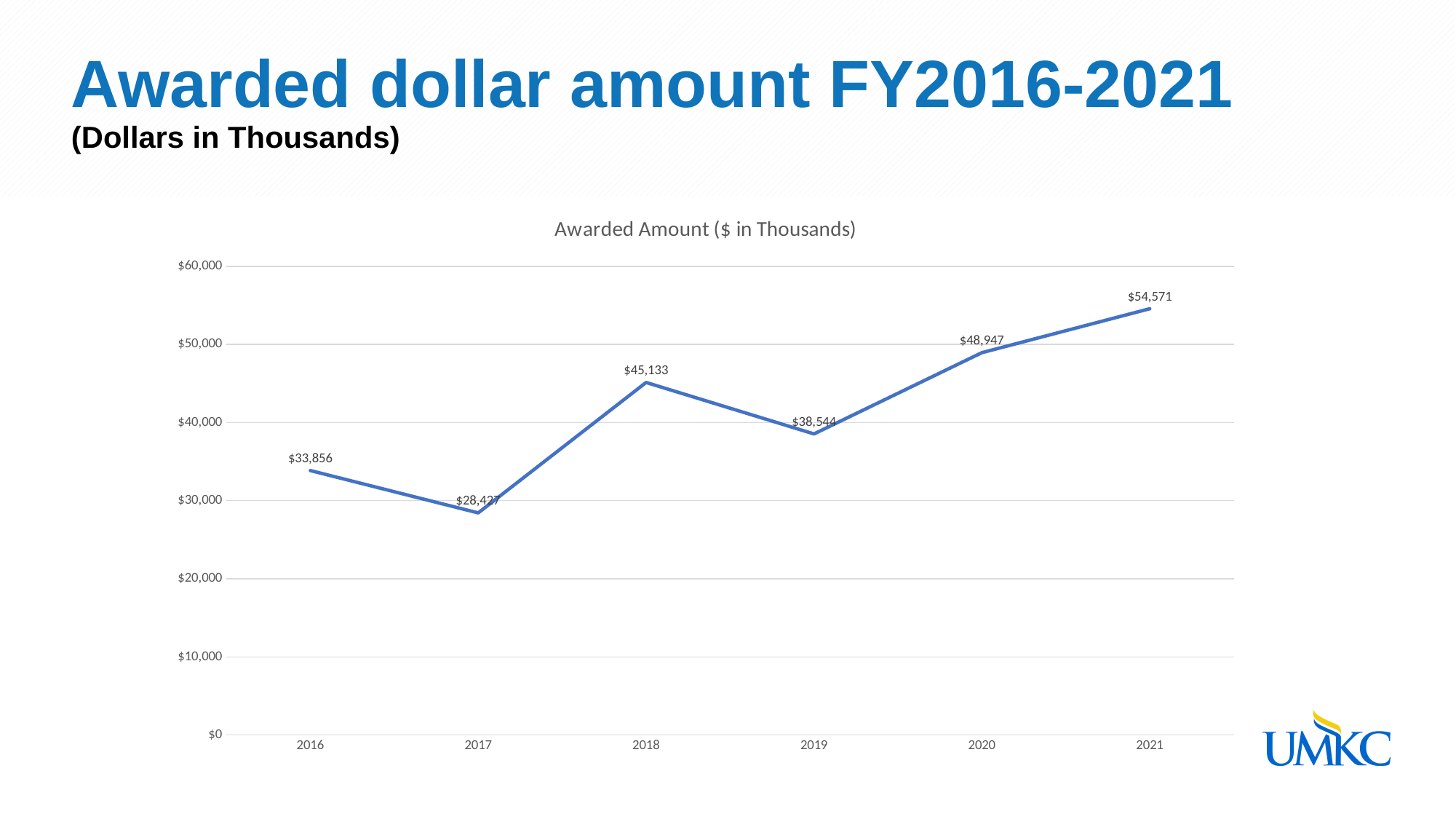
How many years are plotted on the chart? 6 What is the difference between the awarded amounts for 2021 and 2020? $5,624 What type of chart is shown on the slide? line chart What is the awarded amount for 2020? $48,947 Is the awarded amount for 2017 greater or less than $30,000? less What is the awarded amount for 2018? $45,133 What is the difference between the awarded amounts for 2018 and 2019? $6,589 Which year has a larger awarded amount, 2018 or 2019? 2018 What is the awarded amount for 2021? $54,571 What is the awarded amount for 2016? $33,856 Which year has the highest awarded amount? 2021 Which year has the lowest awarded amount? 2017